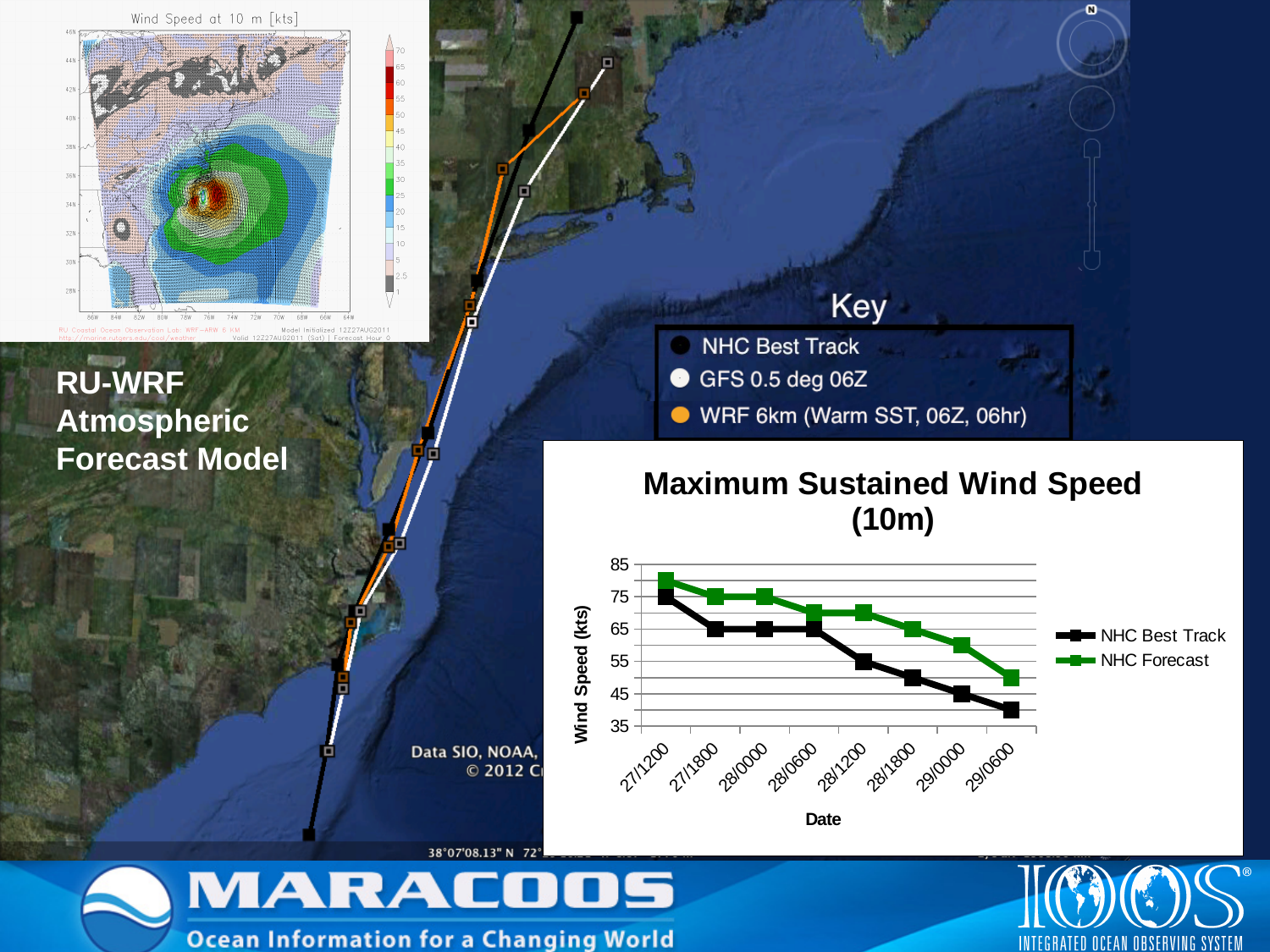
On the 'Maximum Sustained Wind Speed (10m)' chart, what is the difference between the NHC Forecast and NHC Best Track values at 27/1800? 10 On the 'Maximum Sustained Wind Speed (10m)' chart, is the NHC Forecast value at 27/1200 greater or less than 75? greater On the 'Maximum Sustained Wind Speed (10m)' chart, what is the NHC Best Track wind speed at 27/1200? 75 On the 'Maximum Sustained Wind Speed (10m)' chart, is the NHC Best Track value at 29/0600 greater or less than 45? less On the 'Maximum Sustained Wind Speed (10m)' chart, do the NHC Best Track values rise or fall from 27/1200 to 29/0600? fall On the 'Maximum Sustained Wind Speed (10m)' chart, what is the NHC Forecast wind speed at 28/1800? 65 On the 'Maximum Sustained Wind Speed (10m)' chart, what is the NHC Best Track wind speed at 28/1200? 55 On the 'Maximum Sustained Wind Speed (10m)' chart, what kind of chart is shown? line chart On the 'Maximum Sustained Wind Speed (10m)' chart, how many dates are shown on the x axis? 8 On the 'Maximum Sustained Wind Speed (10m)' chart, what is the NHC Forecast wind speed at 28/0000? 75 On the 'Maximum Sustained Wind Speed (10m)' chart, how many series does the legend list? 2 On the 'Maximum Sustained Wind Speed (10m)' chart, at 28/1800, which series has the higher value, NHC Best Track or NHC Forecast? NHC Forecast